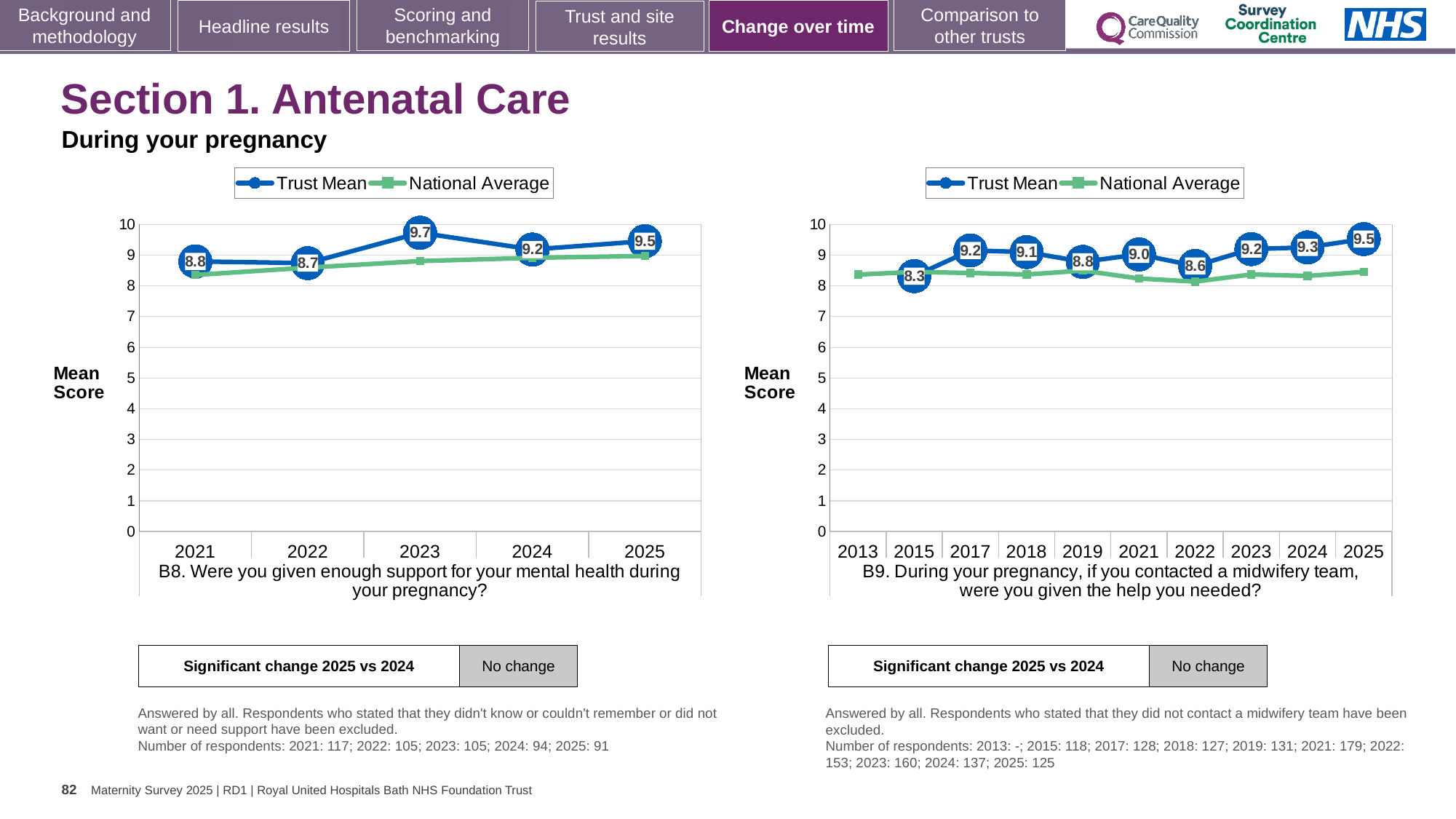
In the B8 chart (left), what is the Trust Mean for 2023? 9.7 In the B8 chart (left), what is the difference between the Trust Mean in 2023 and in 2022? 1.0 What type of chart is the B8 chart (left)? Line chart In the B8 chart (left), how many years are shown on the x axis? 5 How many series does the legend of the B9 chart (right) list? 2 In the B8 chart (left), which year has the lowest Trust Mean? 2022 In the B9 chart (right), is the Trust Mean for 2024 or for 2019 larger? 2024 In the B8 chart (left), what is the Trust Mean for 2025? 9.5 In the B9 chart (right), what is the Trust Mean for 2022? 8.6 In the B9 chart (right), what is the Trust Mean for 2015? 8.3 In the B9 chart (right), which year has the highest Trust Mean? 2025 In the B9 chart (right), is the National Average for 2025 greater or less than 9? less